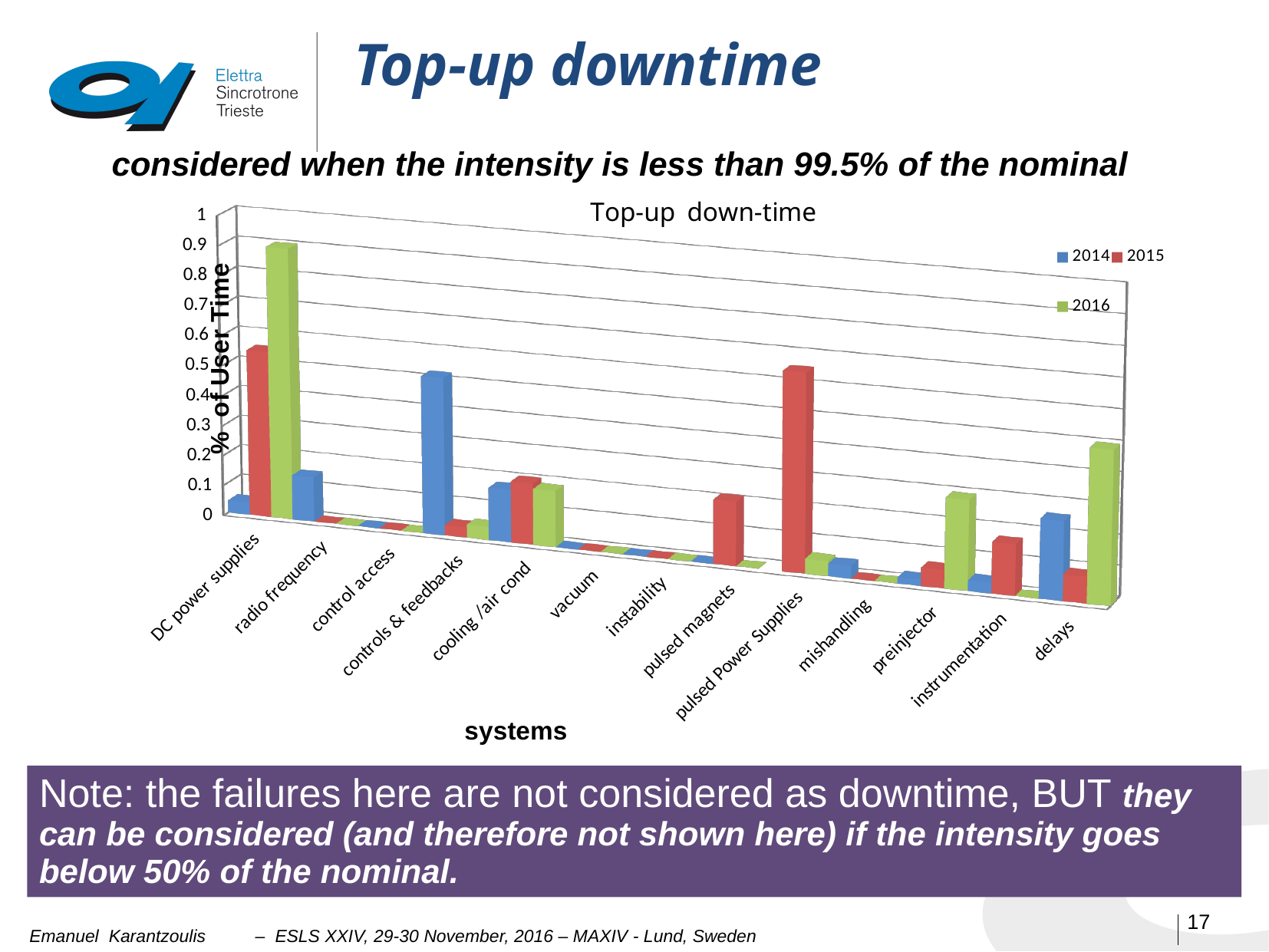
What is the label on the vertical axis of the chart? % of User Time What kind of chart is shown on the slide? bar chart For pulsed Power Supplies, which series has the larger value, 2015 or 2016? 2015 Which is larger: the 2016 value for DC power supplies or the 2014 value for controls & feedbacks? 2016 value for DC power supplies How many series does the chart legend list? 3 Which category has the highest value for the 2014 series? controls & feedbacks Which category has the highest value for the 2016 series? DC power supplies Is the 2015 value for pulsed Power Supplies greater or less than 0.3? greater Is the 2016 value for DC power supplies greater or less than 0.5? greater How many system categories are shown on the x axis of the chart? 13 Which category has the highest bar in the chart overall? DC power supplies